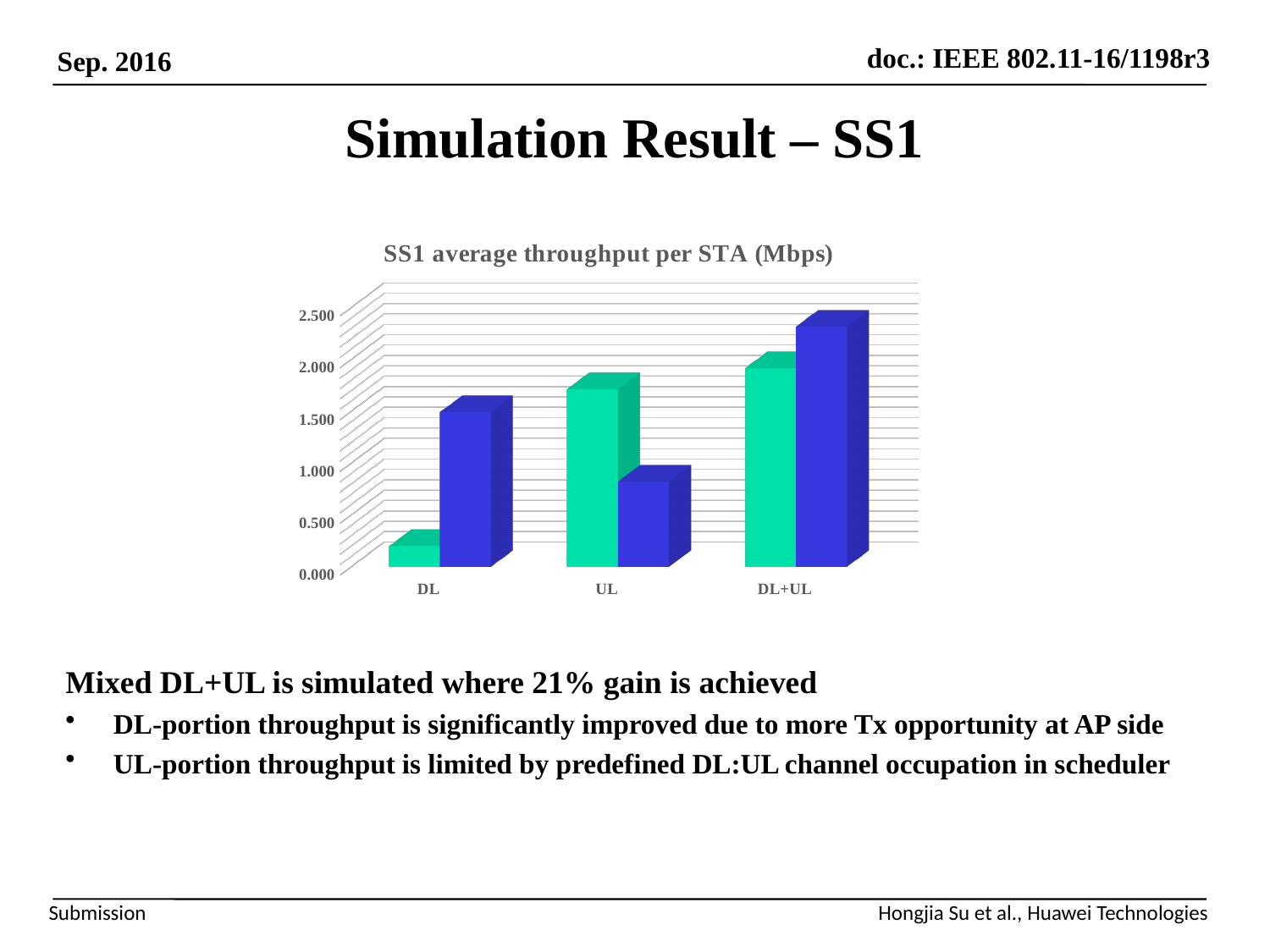
Is the value of the blue bar for DL greater or less than 1.000? greater Which category has the tallest bar in the chart? DL+UL For the DL category, which bar is larger, the green one or the blue one? the blue one What kind of chart is shown on the slide? bar chart Is the value of the blue bar for DL+UL greater or less than 2.000? greater Is the value of the green bar for UL greater or less than 1.500? greater Which category has the shortest bar in the chart? DL How many categories are shown on the x axis of the chart? 3 Do the green bars rise or fall from DL to UL to DL+UL? rise What is the title of the chart? SS1 average throughput per STA (Mbps)